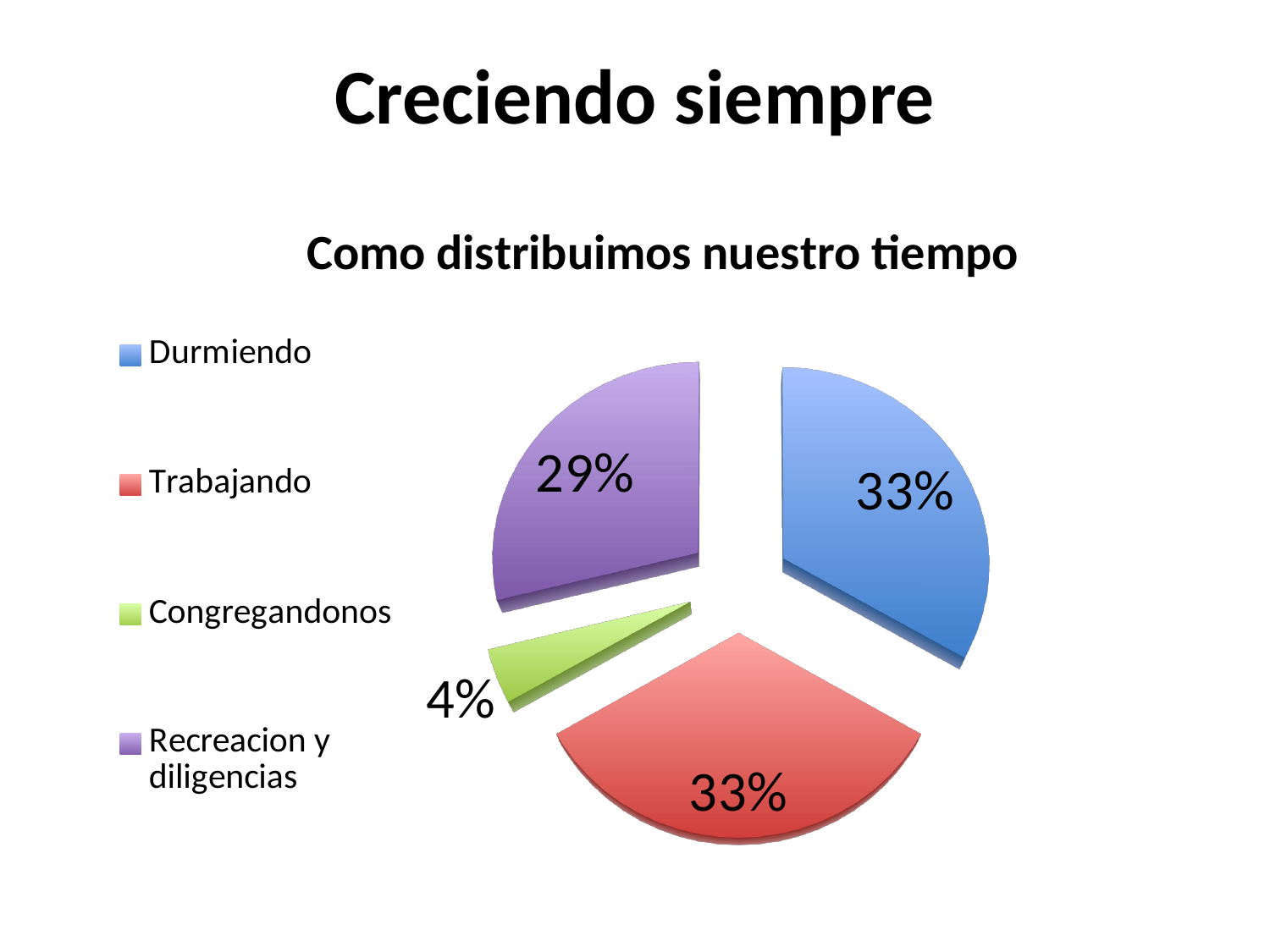
What is the title of the chart? Como distribuimos nuestro tiempo Which is larger, the slice for Trabajando or the slice for Recreacion y diligencias? Trabajando What is the difference in percentage points between Recreacion y diligencias and Congregandonos? 25 What share of time is shown for Trabajando? 33% What is the difference in percentage points between Durmiendo and Recreacion y diligencias? 4 Which is larger, the slice for Recreacion y diligencias or the slice for Congregandonos? Recreacion y diligencias Which category has the smallest slice of the pie? Congregandonos What kind of chart is shown on the slide? Pie chart What share of time is shown for Congregandonos? 4% What share of time is shown for Recreacion y diligencias? 29% How many categories does the pie chart show? 4 What share of time is shown for Durmiendo? 33%